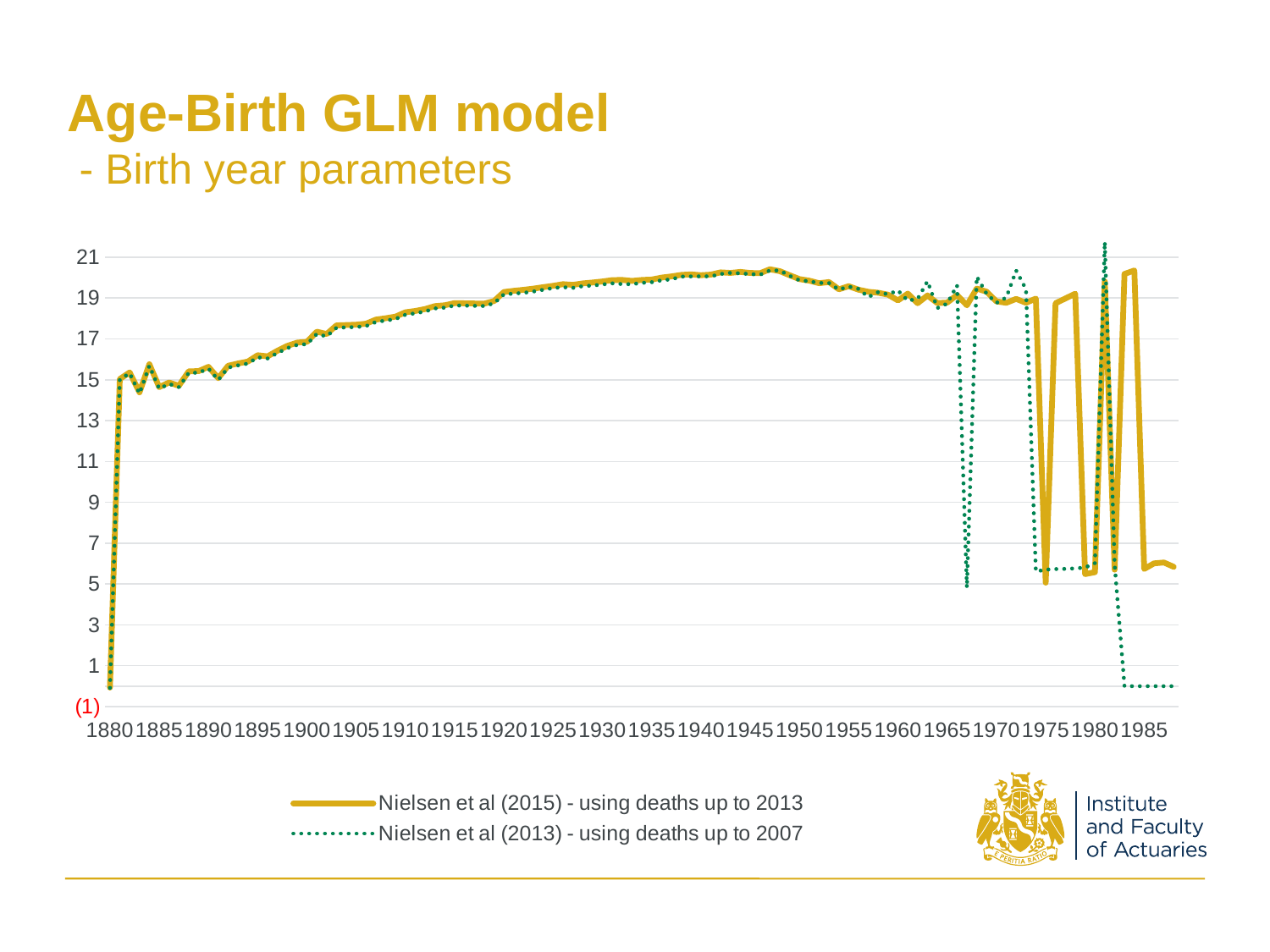
Which series is drawn with a dotted line? Nielsen et al (2013) - using deaths up to 2007 Is the value for Nielsen et al (2015) - using deaths up to 2013 at 1945 greater or less than 19? greater How many series does the legend list? 2 Is the value for Nielsen et al (2013) - using deaths up to 2007 at 1975 greater or less than 7? less What is the title of the slide containing the chart? Age-Birth GLM model - Birth year parameters Is the value for Nielsen et al (2015) - using deaths up to 2013 at 1985 greater or less than 5? greater At 1985, which series has the larger value: Nielsen et al (2015) - using deaths up to 2013 or Nielsen et al (2013) - using deaths up to 2007? Nielsen et al (2015) - using deaths up to 2013 What kind of chart is shown on the slide? line chart Between 1900 and 1945, do the values for Nielsen et al (2015) - using deaths up to 2013 generally rise or fall? rise